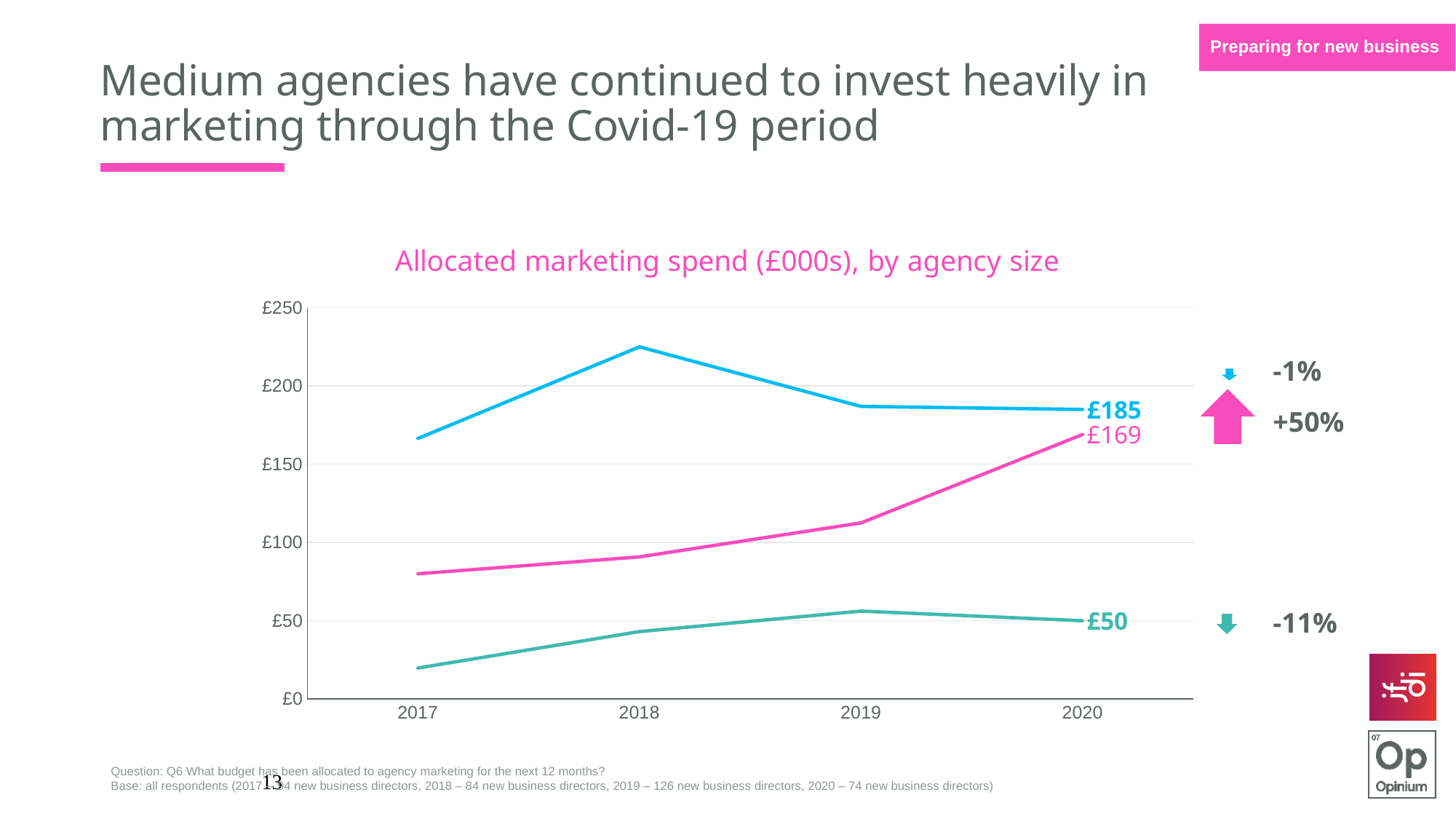
What type of chart is shown on the slide? line chart What is the chart's title? Allocated marketing spend (£000s), by agency size What is the difference between the blue line's and the pink line's values in 2020? £16 What is the value of the blue line in 2020? £185 Is the value of the blue line in 2018 greater or less than £200? greater What is the difference between the blue line's and the green line's values in 2020? £135 Is the value of the pink line in 2017 greater or less than £100? less How many years are shown on the x axis? 4 What is the value of the green line in 2020? £50 Which line has the highest value in 2020? the blue line Which line has the lowest value in 2020? the green line What is the value of the pink line in 2020? £169